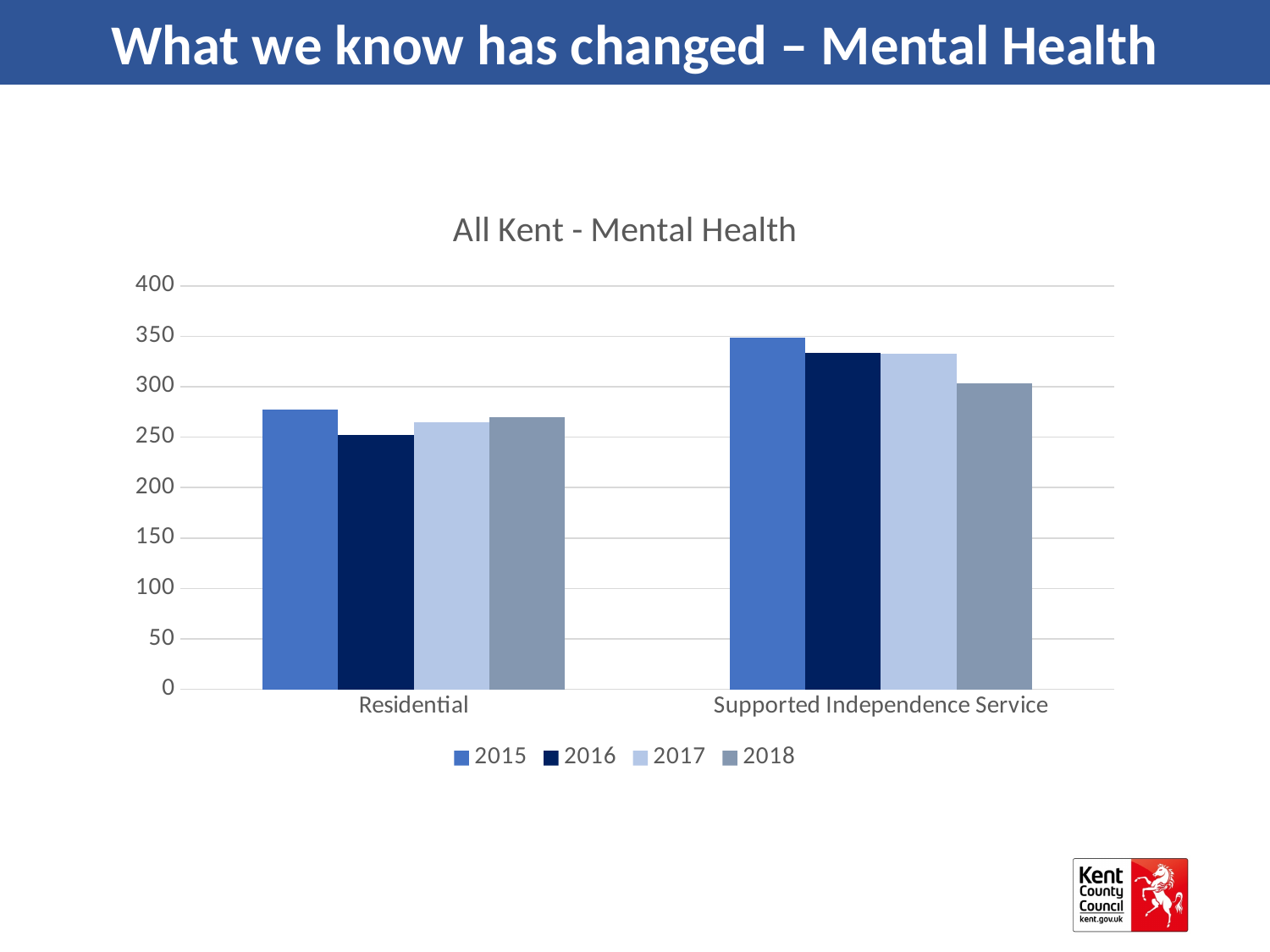
What type of chart is shown on the slide? Bar chart Which year has the highest value for Residential? 2015 How many series does the legend list? 4 Is the 2015 value for Supported Independence Service greater or less than 300? greater What is the title of the chart? All Kent - Mental Health Which year has the lowest value for Residential? 2016 Is the 2015 value for Residential greater or less than 250? greater How many categories are shown on the x axis? 2 Is the 2016 value for Residential greater or less than 300? less Which year has the lowest value for Supported Independence Service? 2018 Which is larger, the 2015 value for Residential or the 2015 value for Supported Independence Service? Supported Independence Service